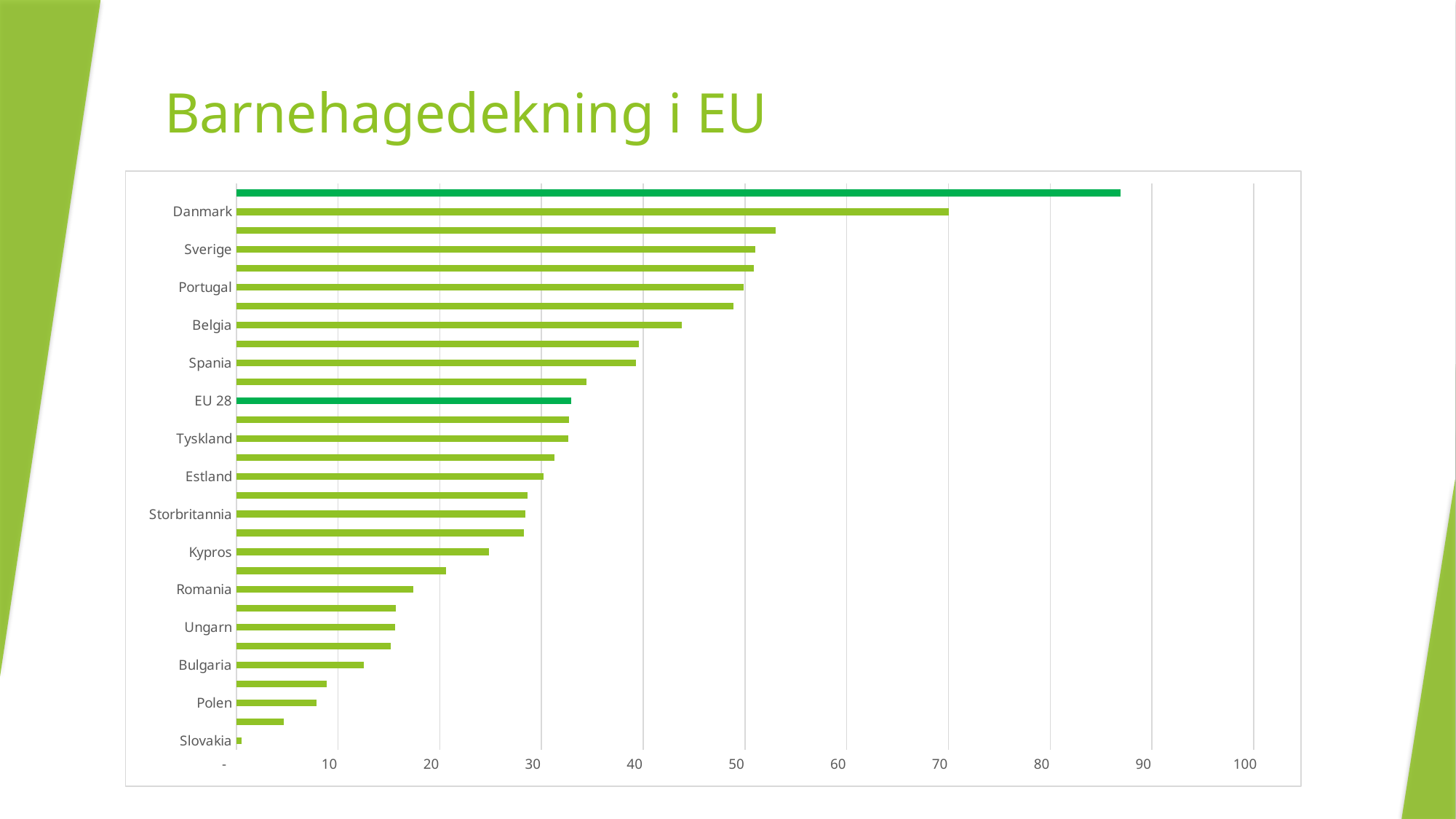
Is the value for EU 28 greater or less than 30? greater Is the value for Storbritannia greater or less than 30? less Which has the larger value, Kypros or Romania? Kypros What is the title of the chart? Barnehagedekning i EU Which of the labelled countries has the lowest value? Slovakia Which has the larger value, Danmark or Sverige? Danmark Is the value for Belgia greater or less than 50? less Do the bar values increase or decrease going from the top of the chart to the bottom? decrease What kind of chart is shown on the slide? bar chart